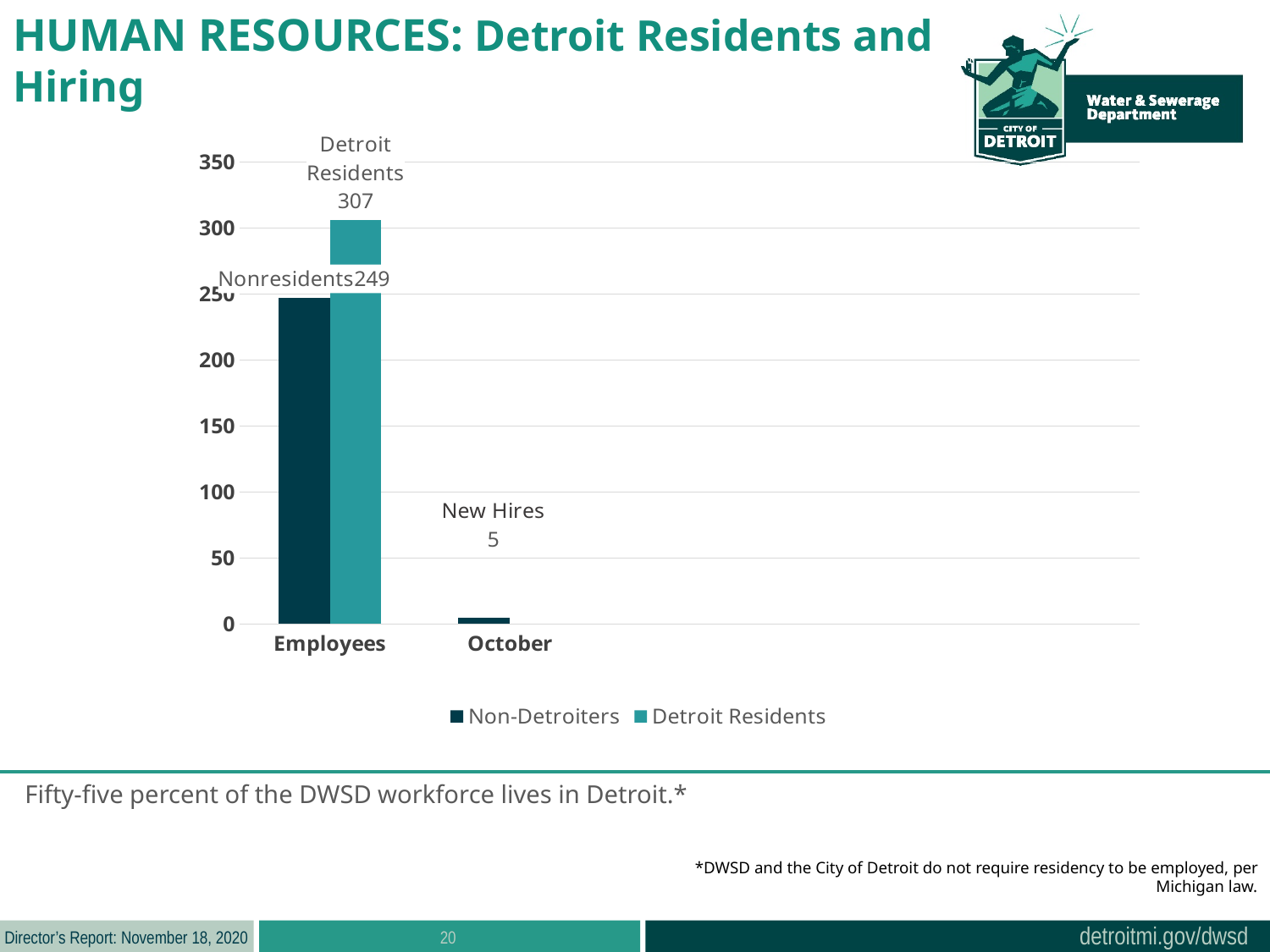
In the Employees category, which is larger: Detroit Residents or Nonresidents? Detroit Residents How many series does the legend list? 2 What is the difference between Detroit Residents (307) and Nonresidents (249) in the Employees category? 58 What is the value for Nonresidents in the Employees category? 249 What is the value labeled New Hires in the October category? 5 Which category has the lowest bar on the chart? October What are the two series named in the legend? Non-Detroiters and Detroit Residents How many categories are shown on the x axis? 2 Is the value for Nonresidents in the Employees category greater or less than 200? greater Is the value for New Hires in October greater or less than 50? less What is the value for Detroit Residents in the Employees category? 307 What kind of chart is shown on the slide? bar chart